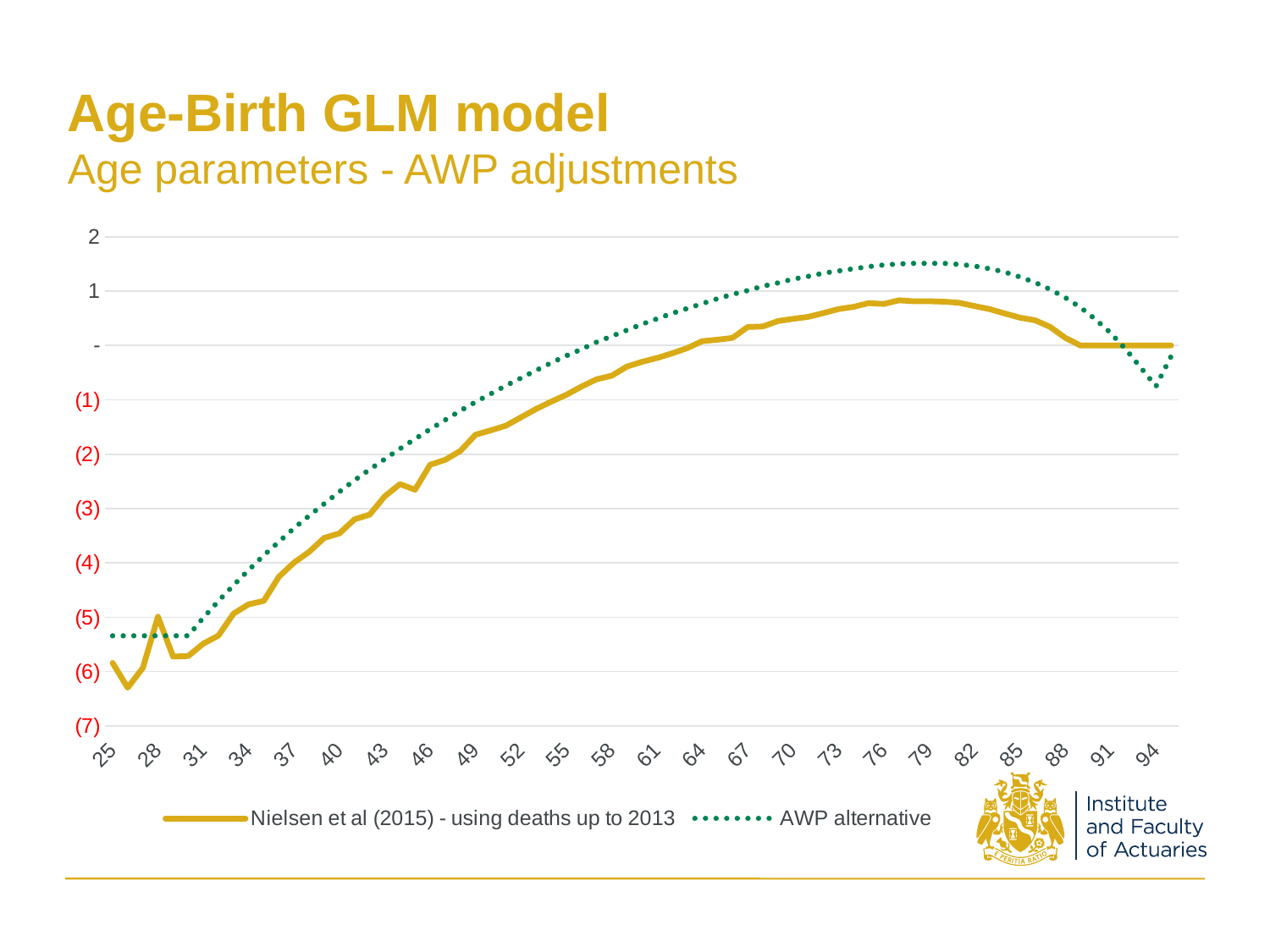
How many series does the legend list? 2 Is the value of the Nielsen et al (2015) series at age 25 greater or less than (5)? less Is the value of the AWP alternative series at age 79 greater or less than 1? greater What kind of chart is shown on the slide? line chart How many age labels are shown on the x axis? 24 What are the two series named in the legend? Nielsen et al (2015) - using deaths up to 2013; AWP alternative Do the values of the Nielsen et al (2015) series rise or fall between age 31 and age 64? rise At age 94, which series has the higher value, Nielsen et al (2015) or AWP alternative? Nielsen et al (2015) - using deaths up to 2013 At age 79, which series has the higher value, Nielsen et al (2015) or AWP alternative? AWP alternative Is the value of the Nielsen et al (2015) series at age 79 greater or less than 1? less Which series is drawn as a dotted green line? AWP alternative